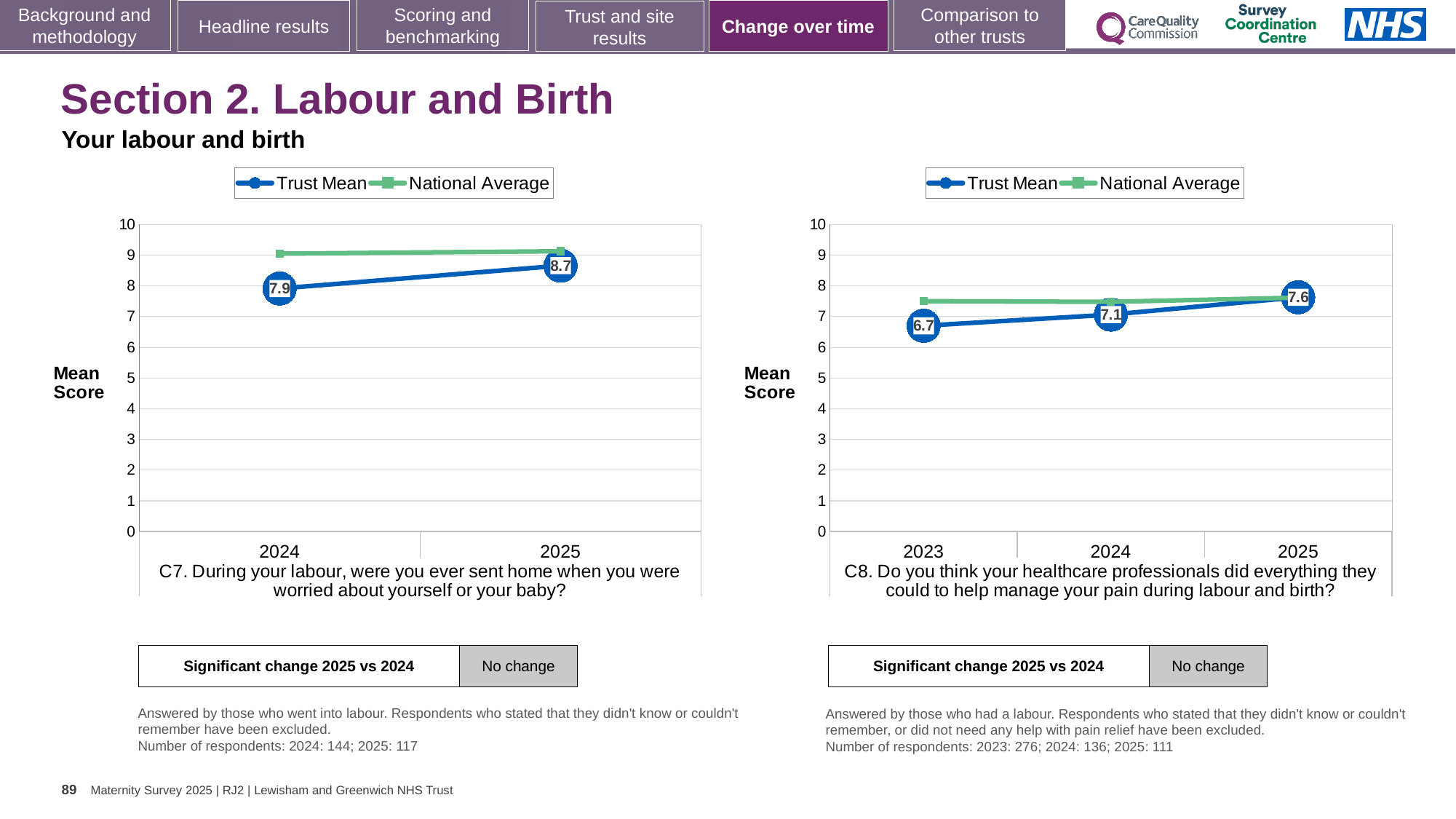
In the C7 chart (left), does the Trust Mean rise or fall from 2024 to 2025? rise In the C8 chart (right), what is the difference between the Trust Mean in 2025 and in 2023? 0.9 In the C8 chart (right), what is the Trust Mean score for 2025? 7.6 In the C8 chart (right), how many years are plotted on the x axis? 3 How many series does the legend of the C7 chart (left) list? 2 In the C7 chart (left), what is the Trust Mean score for 2025? 8.7 In the C7 chart (left), by how much did the Trust Mean change from 2024 to 2025? 0.8 What type of chart is the C8 chart (right)? line chart In the C7 chart (left), is the National Average for 2024 greater or less than 8? greater In the C8 chart (right), what is the Trust Mean score for 2023? 6.7 In the C7 chart (left), what is the Trust Mean score for 2024? 7.9 In the C8 chart (right), which year has the lowest Trust Mean score? 2023